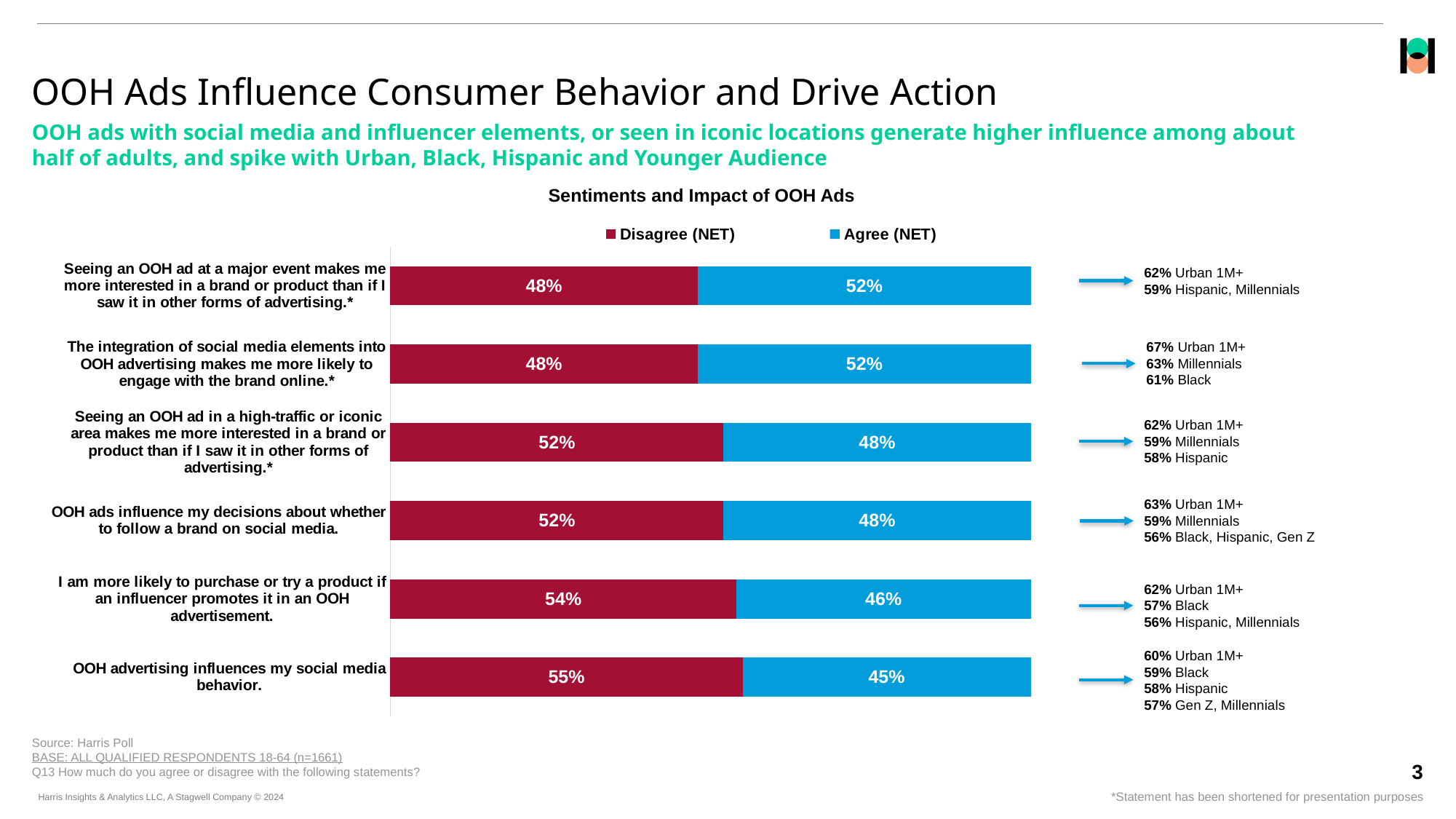
For "OOH ads influence my decisions about whether to follow a brand on social media.", which is larger: Disagree (NET) or Agree (NET)? Disagree (NET) Which statement has the highest Disagree (NET) value? OOH advertising influences my social media behavior. What is the title of the chart? Sentiments and Impact of OOH Ads What is the Agree (NET) value for "OOH advertising influences my social media behavior."? 45% What is the difference between the Disagree (NET) and Agree (NET) values for "OOH advertising influences my social media behavior."? 10% Which statement has the lowest Agree (NET) value? OOH advertising influences my social media behavior. What is the Disagree (NET) value for "I am more likely to purchase or try a product if an influencer promotes it in an OOH advertisement."? 54% What kind of chart is shown on the slide? Stacked bar chart What is the total of the Disagree (NET) and Agree (NET) values for "Seeing an OOH ad at a major event makes me more interested in a brand or product than if I saw it in other forms of advertising."? 100% How many series does the legend list? 2 How many statements are plotted in the chart? 6 What is the Agree (NET) value for "The integration of social media elements into OOH advertising makes me more likely to engage with the brand online."? 52%